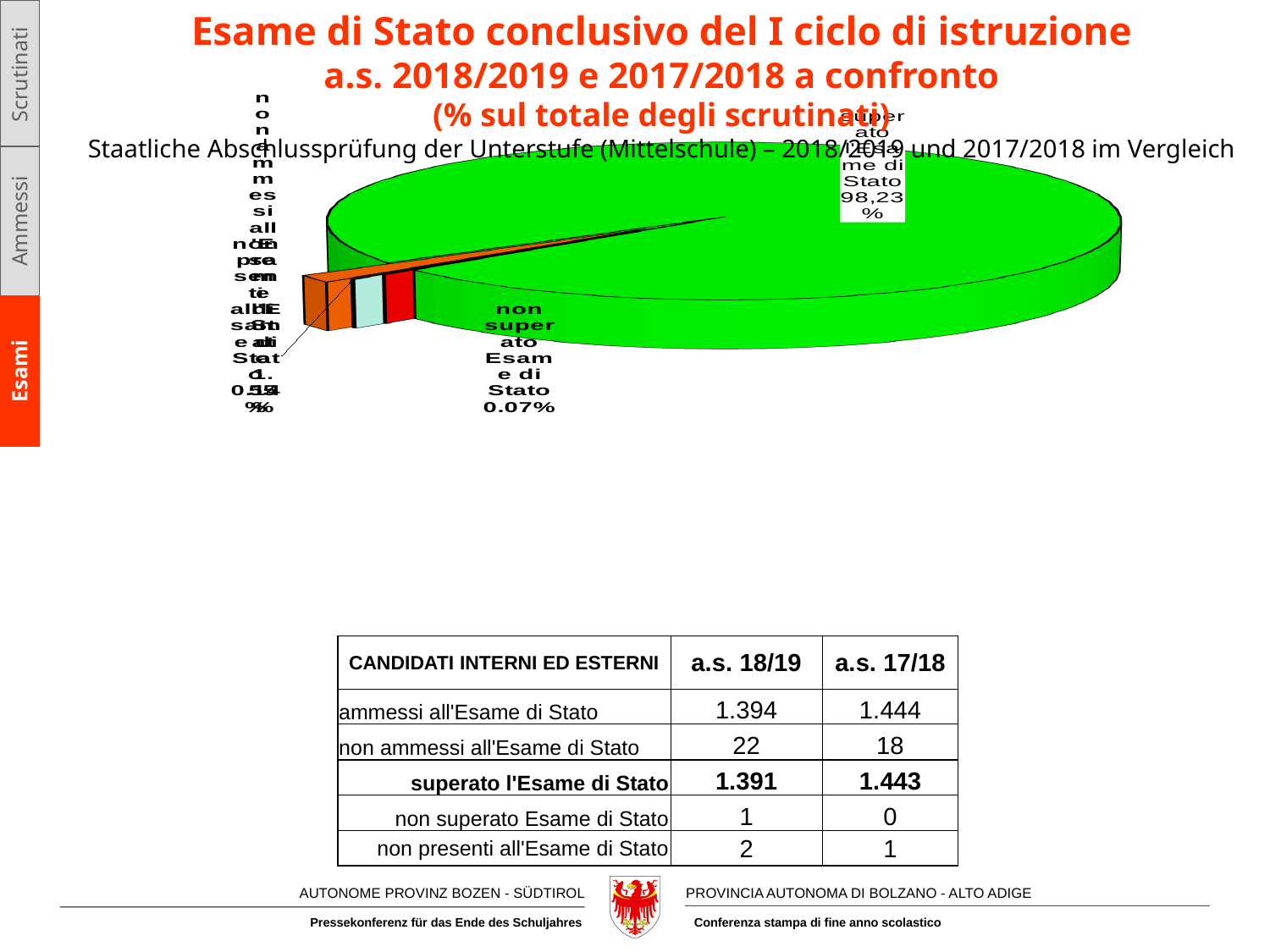
What kind of chart is shown on the slide? pie chart Which slice of the pie chart is the largest? superato Esame di Stato Which is larger in the pie chart: 'superato Esame di Stato' or 'non superato Esame di Stato'? superato Esame di Stato What colour is the largest slice of the pie chart? green What percentage is shown for the slice labelled 'superato Esame di Stato'? 98,23% What percentage is shown for the slice labelled 'non superato Esame di Stato'? 0.07% Does the 'superato Esame di Stato' slice make up more or less than half of the pie? more